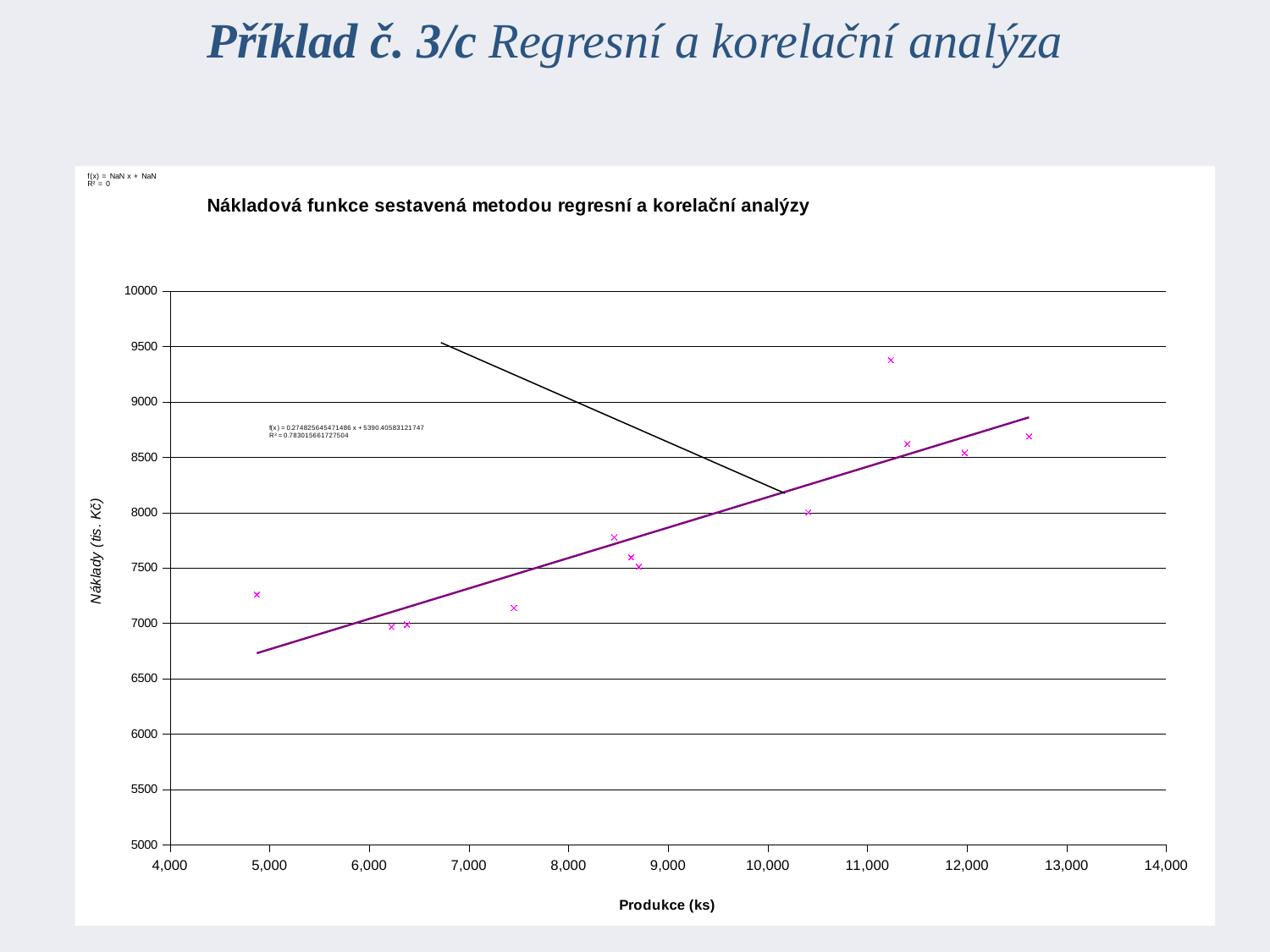
Is the cost value for the data point at roughly 4,900 ks of production greater or less than 7000? greater What is the maximum value shown on the x axis? 14,000 Is the cost value for the data point at roughly 7,450 ks of production greater or less than 7500? less Is the cost value for the data point at roughly 11,250 ks of production greater or less than 9000? greater Which data point has the highest cost value: the one at roughly 11,250 ks or the one at roughly 12,650 ks? the one at roughly 11,250 ks What is the R² value printed next to the regression equation inside the plot area? 0.783015661727504 What is the label of the x axis? Produkce (ks) Do the plotted costs generally rise or fall as production increases along the x axis? rise What is the maximum value shown on the y axis? 10000 What is the title of the chart? Nákladová funkce sestavená metodou regresní a korelační analýzy What kind of chart is shown on the slide? scatter chart